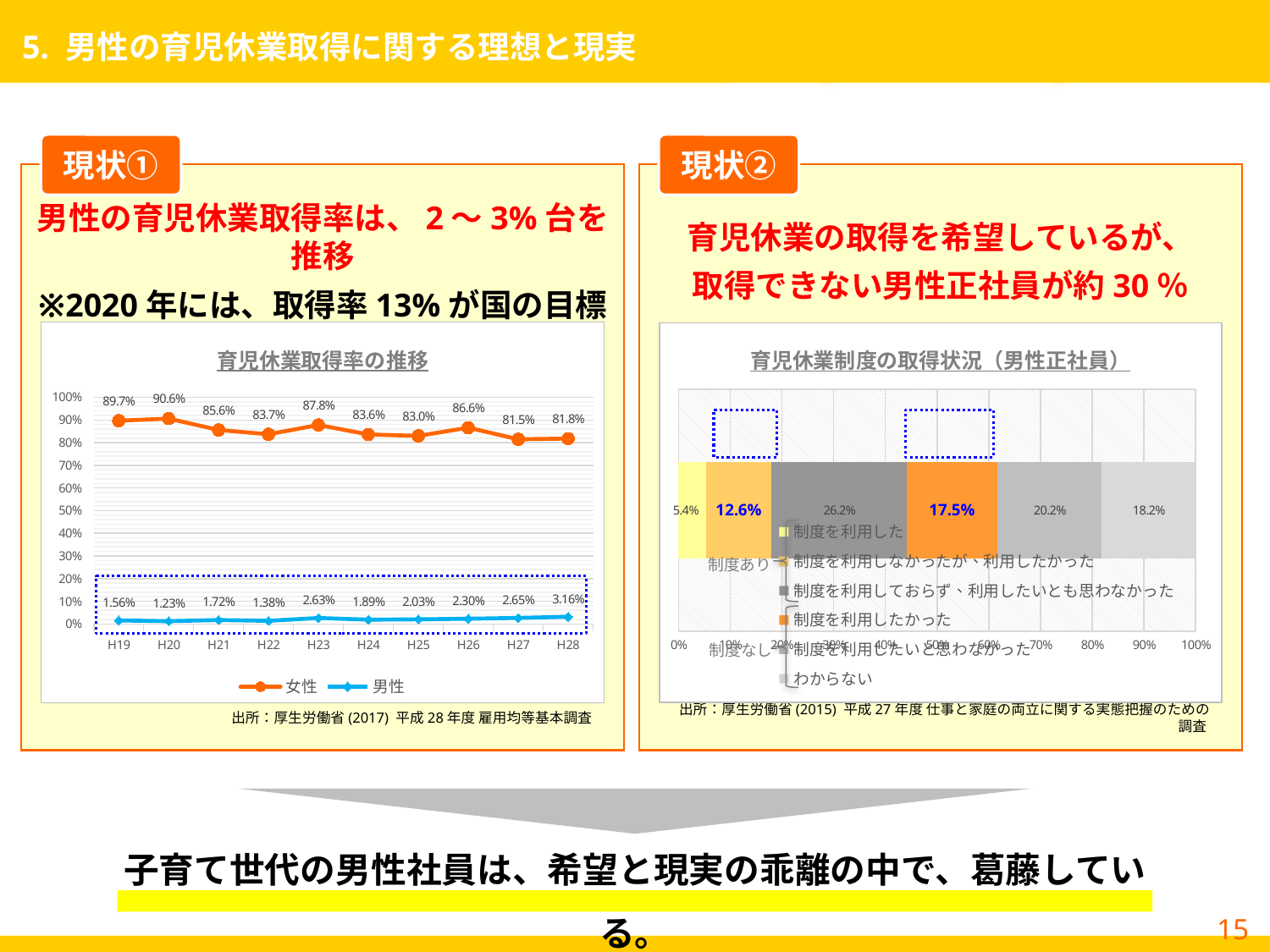
In the chart titled 育児休業制度の取得状況（男性正社員）, what is the value of the orange segment highlighted in blue text? 17.5% In the chart titled 育児休業取得率の推移, what is the value for 男性 in H28? 3.16% In the chart titled 育児休業取得率の推移, what is the value for 男性 in H23? 2.63% What kind of chart is the chart titled 育児休業取得率の推移? line chart In the chart titled 育児休業取得率の推移, in which year is the 男性 value lowest? H20 In the chart titled 育児休業取得率の推移, what is the value for 女性 in H19? 89.7% In the chart titled 育児休業取得率の推移, in which year is the 女性 value highest? H20 In the chart titled 育児休業取得率の推移, what is the difference between the 女性 values in H19 and H28? 7.9% In the chart titled 育児休業取得率の推移, is the 男性 value in H28 greater or less than the 男性 value in H19? greater In the chart titled 育児休業取得率の推移, how many series does the legend list? 2 In the chart titled 育児休業取得率の推移, how many years are shown on the x axis? 10 In the chart titled 育児休業制度の取得状況（男性正社員）, what is the value of the leftmost (yellow) segment? 5.4%